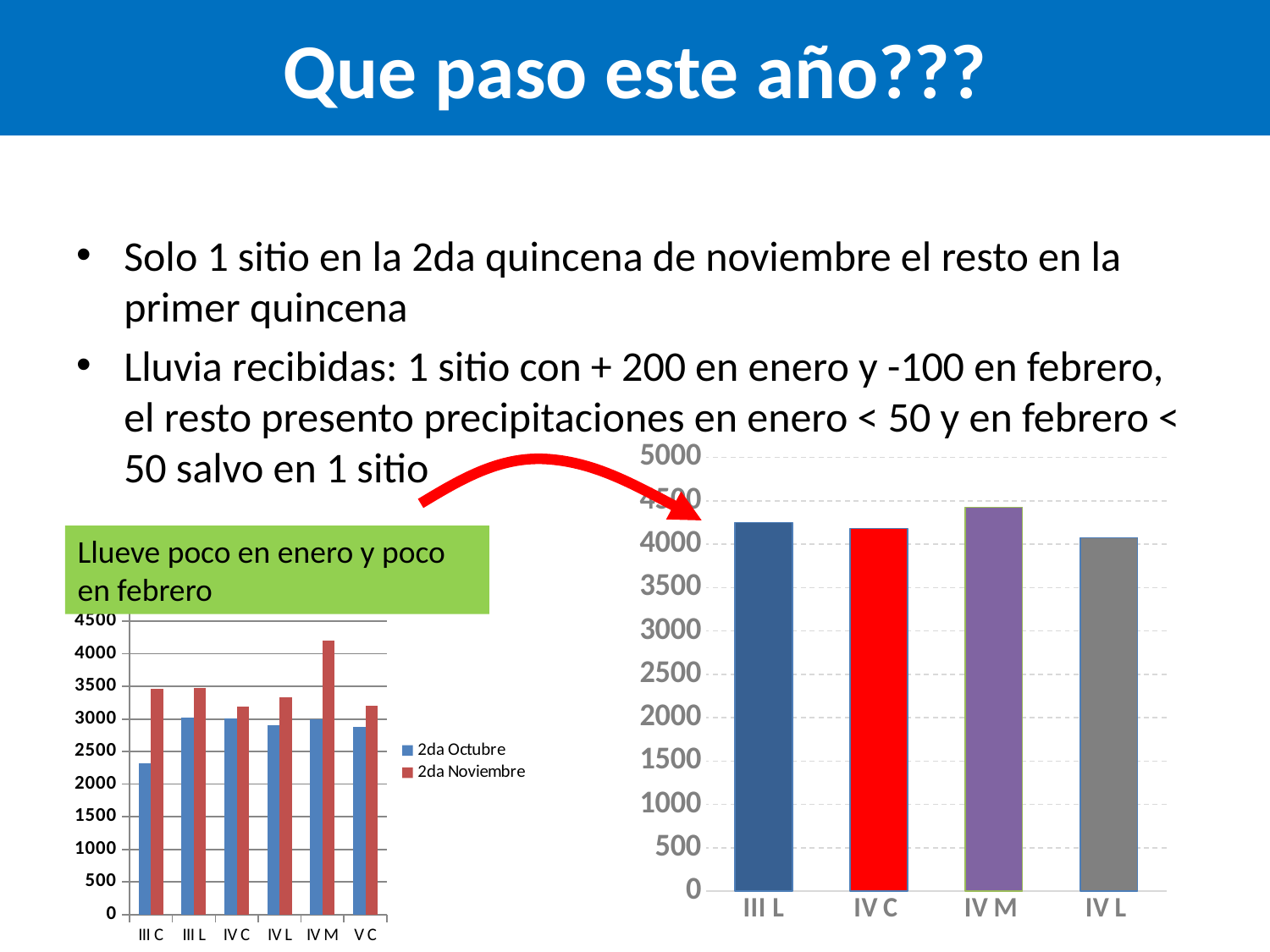
On the chart at the bottom left, what are the two legend entries? 2da Octubre and 2da Noviembre On the chart at the bottom left, how many series does the legend list? 2 On the chart at the bottom left, for III C, which series has the larger value, 2da Octubre or 2da Noviembre? 2da Noviembre On the chart on the right, how many bars are plotted? 4 On the chart at the bottom left, which category has the highest 2da Noviembre value? IV M On the chart at the bottom left, which category has the lowest 2da Octubre value? III C On the chart on the right, which category has the highest value? IV M On the chart at the bottom left, is the 2da Octubre value for III C greater or less than 2500? less On the chart at the bottom left, how many categories are shown on the x axis? 6 What kind of chart is the chart on the right? bar chart On the chart at the bottom left, is the 2da Noviembre value for IV M greater or less than 4000? greater On the chart on the right, is the value for IV L greater or less than 3500? greater